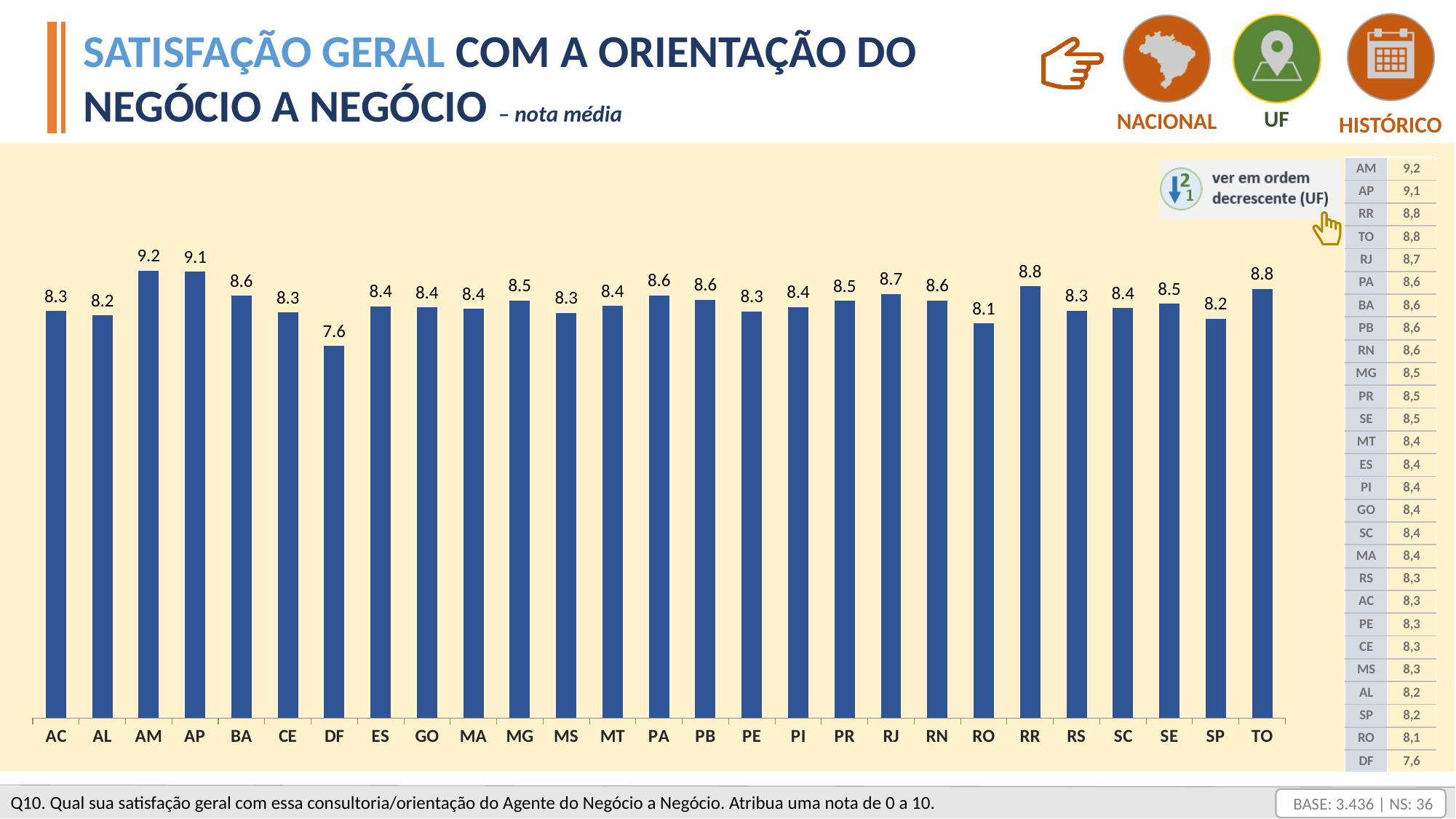
What kind of chart is shown on the slide? bar chart What is the difference between the values for AP and SP? 0.9 What is the value for RJ? 8.7 How many categories are shown on the x axis? 27 Which category has the lowest value? DF What does the subtitle after the chart title say the values represent? nota média What is the difference between the values for AM and DF? 1.6 What is the value for DF? 7.6 Which category has the highest value? AM What is the value for AM? 9.2 What is the value for RO? 8.1 Which is larger, the value for RR or the value for RO? RR